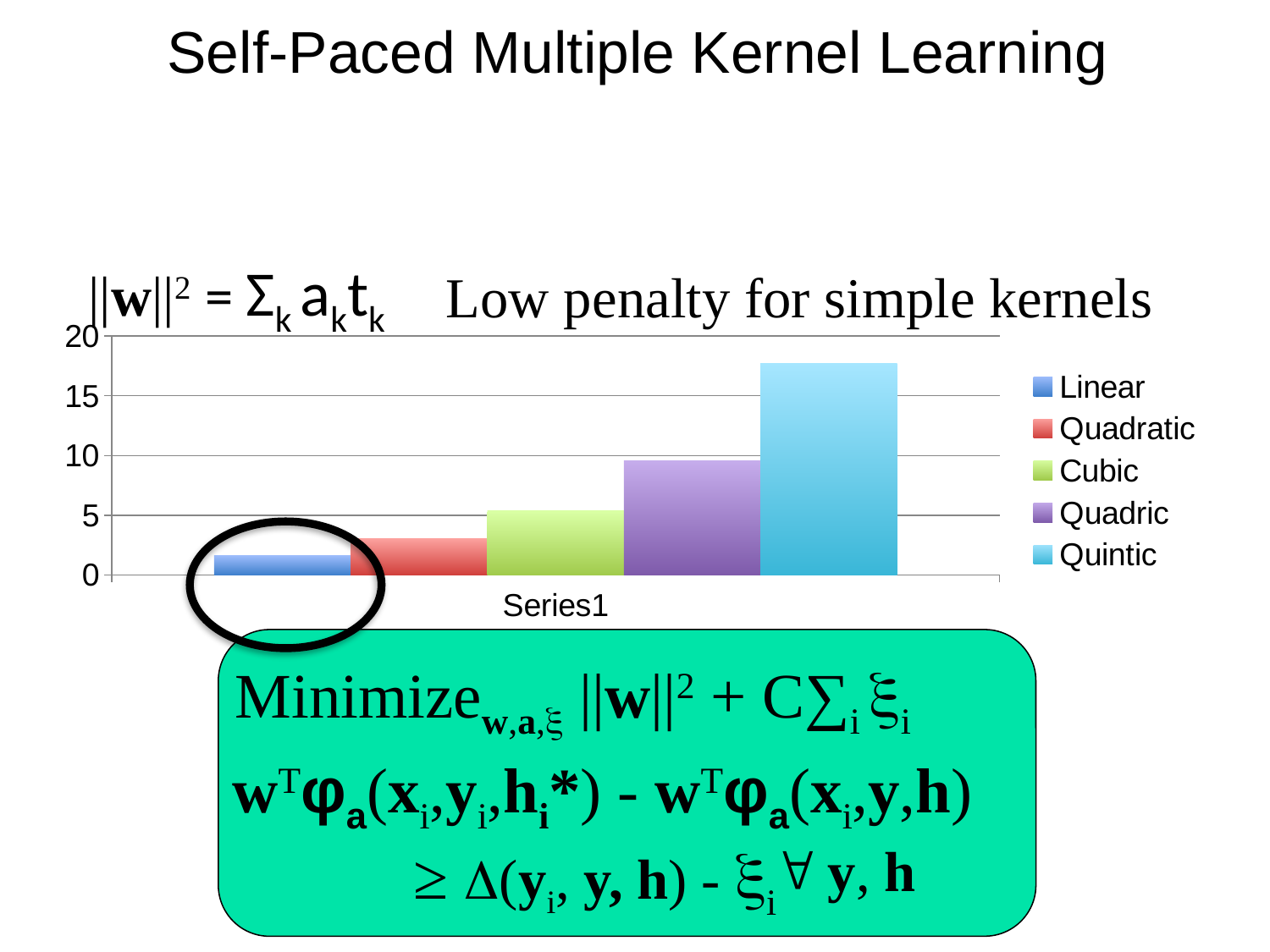
Which series is shown in red in the legend? Quadratic What kind of chart is shown on the slide? bar chart Do the bars rise or fall from Linear to Quintic across the chart? rise What is the label of the single category on the x axis? Series1 Is the value for Quadric greater or less than 5? greater How many series does the chart's legend list? 5 Which series has the highest bar in the chart? Quintic Is the value for Quintic greater or less than 15? greater Which is larger, the bar for Linear or the bar for Quadratic? Quadratic Is the value for Linear greater or less than 5? less Which series has the lowest bar in the chart? Linear Which is larger, the bar for Quadric or the bar for Cubic? Quadric